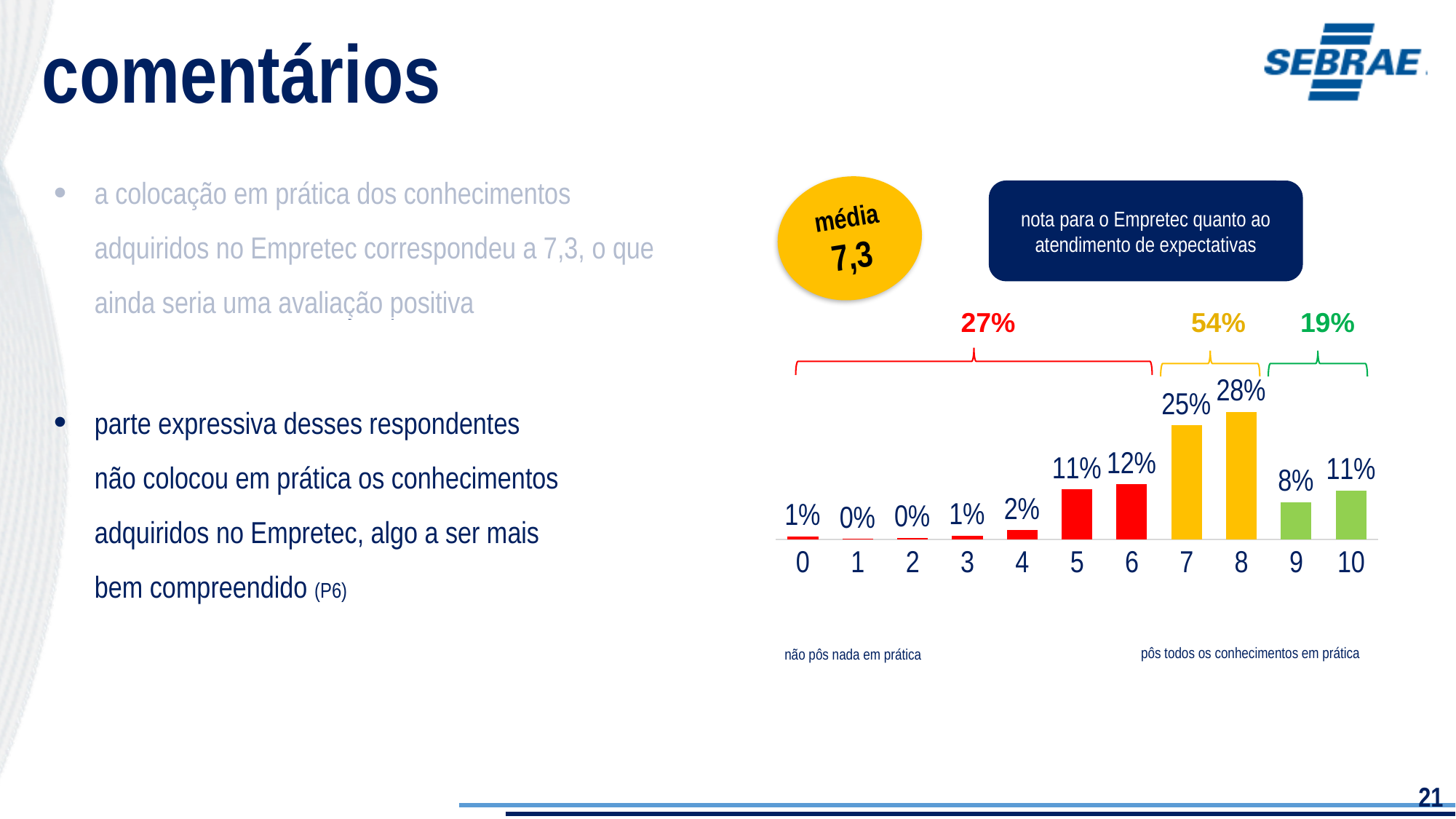
What is the value for category 5? 11% What is the value for category 10? 11% Which is larger, the value for category 9 or the value for category 6? 6 Which category has the highest value? 8 What is the average (média) shown in the yellow circle next to the chart? 7,3 What is the combined share shown above the yellow bars (categories 7 and 8)? 54% What colour are the bars for categories 0 to 6? red How many categories are shown on the x axis? 11 What is the combined share shown above the green bars (categories 9 and 10)? 19% What is the value for category 8? 28% What kind of chart is shown on the slide? bar chart What is the difference between the values for categories 8 and 7? 3%